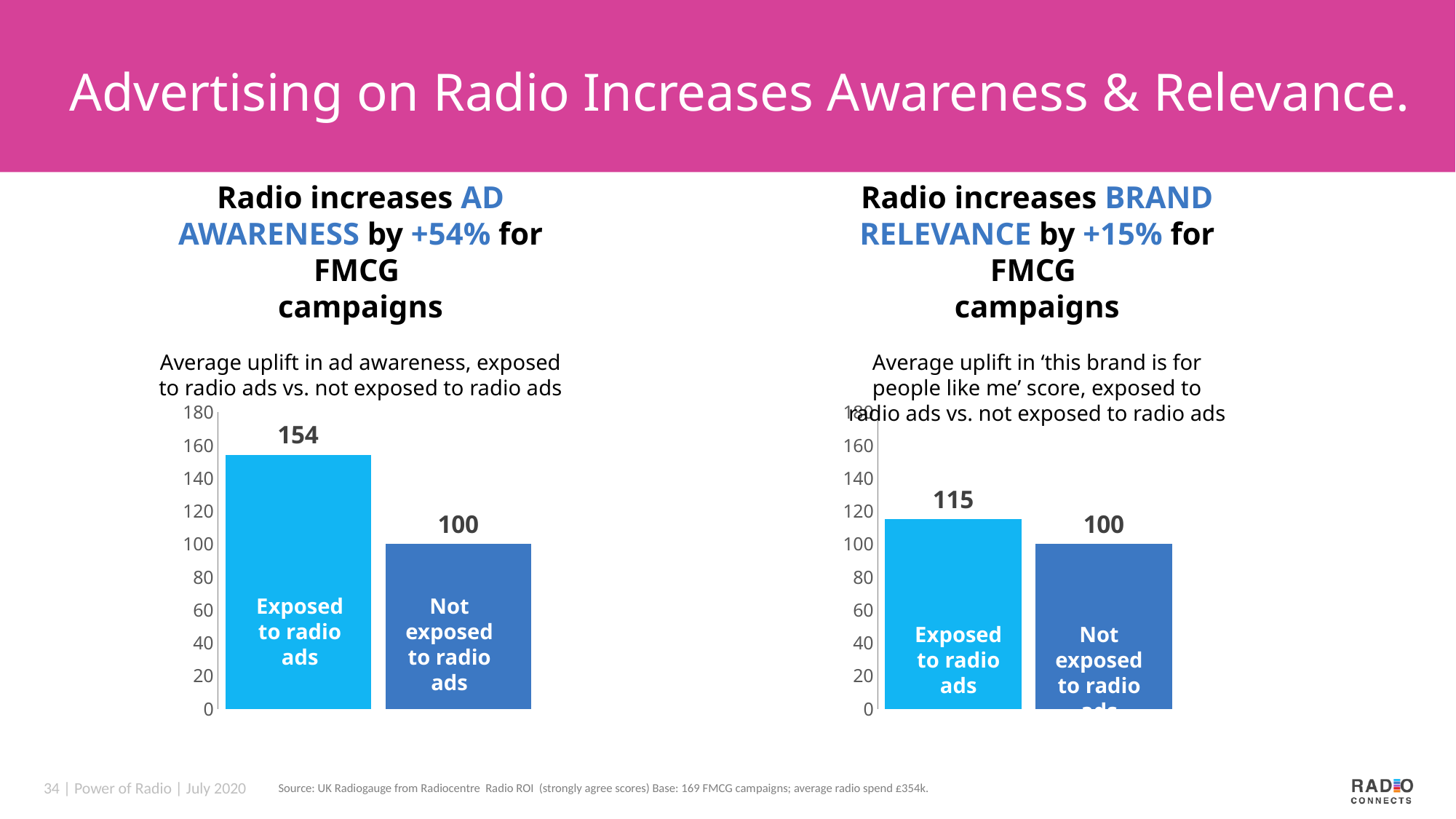
In the right chart (brand relevance), which category has the lowest value? Not exposed to radio ads In the right chart (brand relevance), what is the difference between the 'Exposed to radio ads' and 'Not exposed to radio ads' values? 15 What kind of chart is the left chart (ad awareness)? Bar chart In the left chart (ad awareness), what is the difference between the 'Exposed to radio ads' and 'Not exposed to radio ads' values? 54 In the right chart (brand relevance), what is the value for 'Exposed to radio ads'? 115 In the left chart (ad awareness), what is the value for 'Exposed to radio ads'? 154 Is the 'Exposed to radio ads' value in the left chart (ad awareness) larger or smaller than the 'Exposed to radio ads' value in the right chart (brand relevance)? larger How many bars are shown in the right chart (brand relevance)? 2 In the left chart (ad awareness), is the value for 'Exposed to radio ads' greater or less than 140? greater In the left chart (ad awareness), which category has the highest value? Exposed to radio ads In the left chart (ad awareness), what is the value for 'Not exposed to radio ads'? 100 In the right chart (brand relevance), what is the value for 'Not exposed to radio ads'? 100